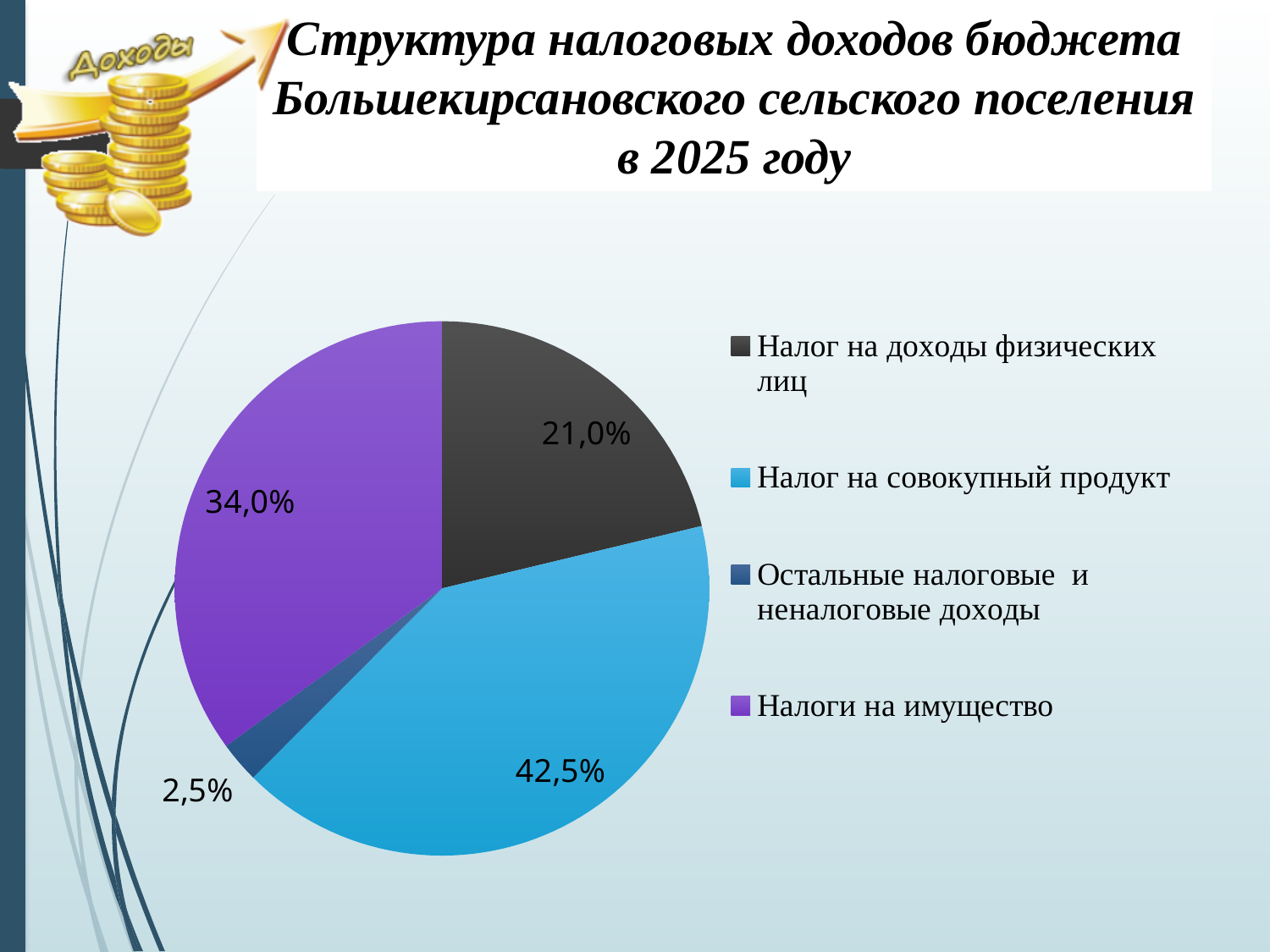
How many slices does the pie chart have? 4 What share of the pie does Налог на доходы физических лиц represent? 21,0% What share of the pie does Остальные налоговые и неналоговые доходы represent? 2,5% Which is larger: the share for Налоги на имущество or the share for Налог на доходы физических лиц? Налоги на имущество What share of the pie does Налоги на имущество represent? 34,0% What kind of chart is shown on the slide? Pie chart Which category has the smallest share of the pie? Остальные налоговые и неналоговые доходы What share of the pie does Налог на совокупный продукт represent? 42,5% Which category has the largest share of the pie? Налог на совокупный продукт What is the difference in percentage points between Налог на доходы физических лиц and Остальные налоговые и неналоговые доходы? 18,5 What is the difference in percentage points between Налог на совокупный продукт and Налоги на имущество? 8,5 What colour is the slice for Налоги на имущество? Purple